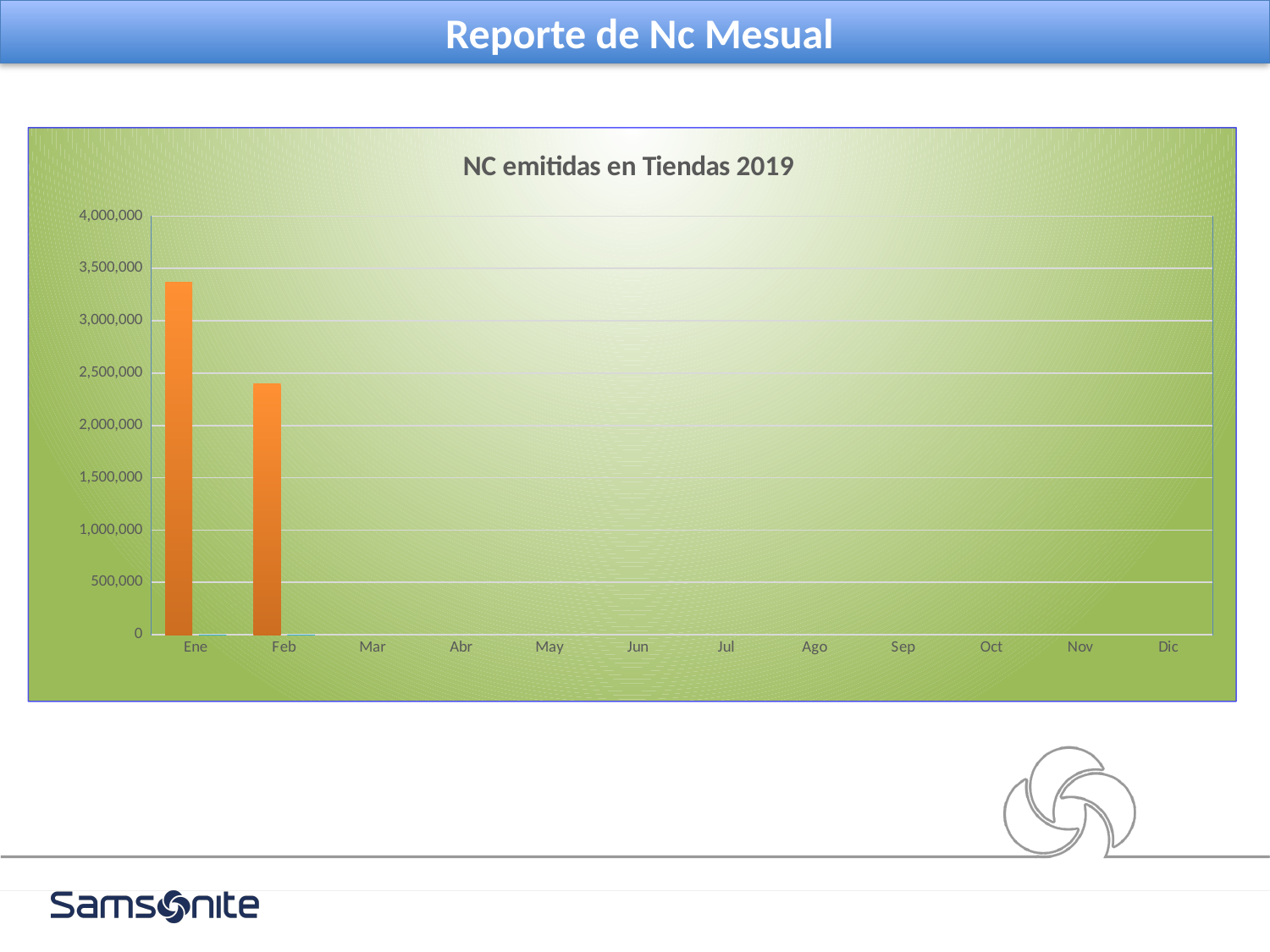
How many months are listed along the x axis of the chart? 12 Is the value for Feb greater or less than 2,500,000? less What is the highest value shown on the y axis of the chart? 4,000,000 Is the value for Ene greater or less than 3,000,000? greater Which month has the highest value in the chart? Ene What is the title of the chart? NC emitidas en Tiendas 2019 Is the value for Ene greater or less than 3,500,000? less What type of chart is shown on the slide? bar chart Does the value rise or fall from Ene to Feb? fall Which month has the larger value, Ene or Feb? Ene How many months show a visible orange bar in the chart? 2